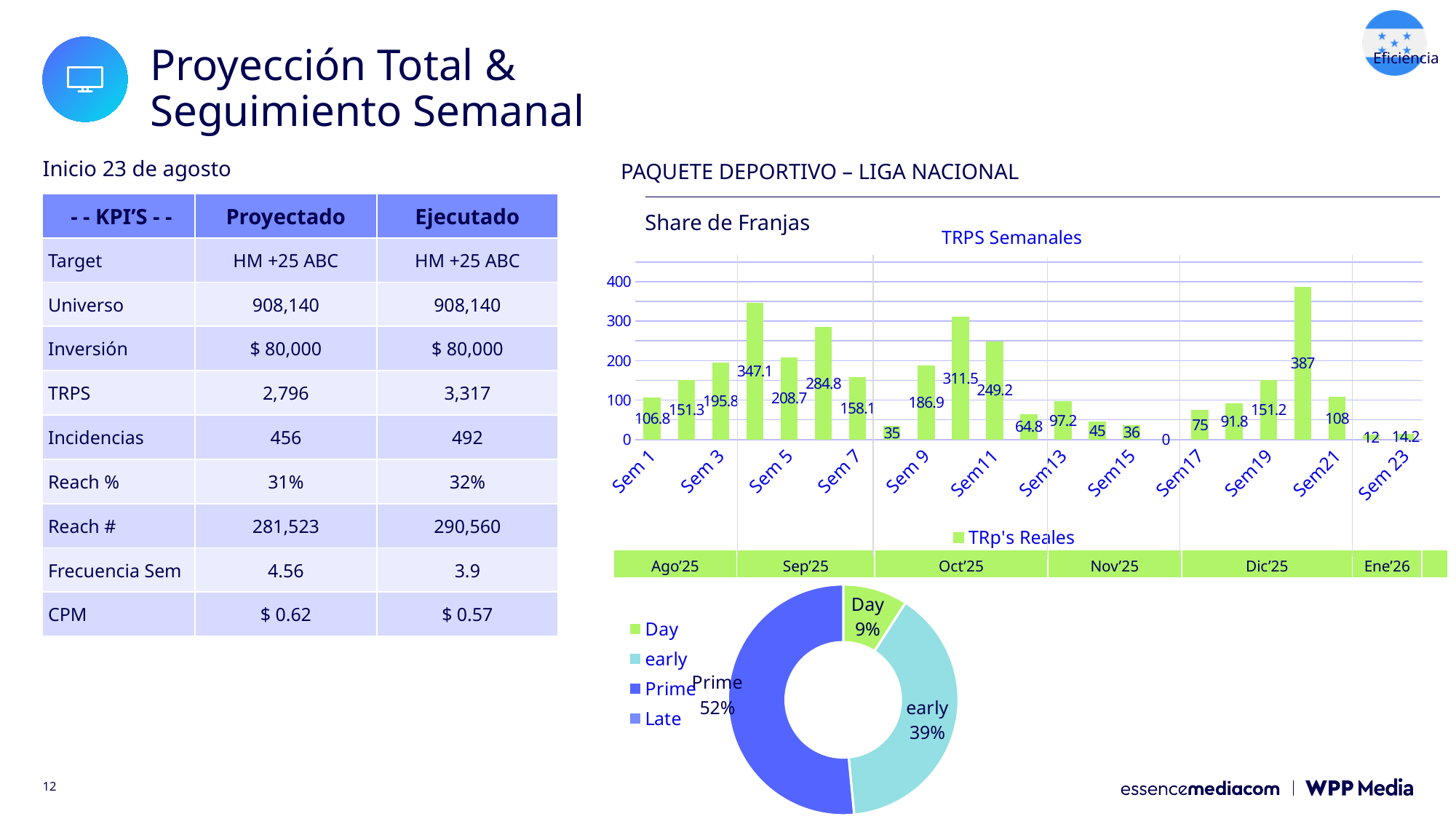
What series name does the legend of the TRPS Semanales chart show? TRp's Reales In the TRPS Semanales bar chart, which is larger, the value for Sem 9 or the value for Sem 13? Sem 9 In the TRPS Semanales bar chart, what is the highest value shown on any bar? 387 What kind of chart is TRPS Semanales? bar chart In the TRPS Semanales bar chart, what is the value for Sem 1? 106.8 In the Share de Franjas donut chart, what share does Prime have? 52% In the TRPS Semanales bar chart, what is the value for Sem 11? 249.2 How many entries does the legend of the Share de Franjas chart list? 4 In the TRPS Semanales bar chart, what is the value for Sem 23? 14.2 In the TRPS Semanales bar chart, is the value for Sem 3 greater or less than 100? greater In the Share de Franjas donut chart, which segment has the smallest labelled share? Day In the TRPS Semanales bar chart, what is the difference between the values for Sem 5 and Sem 7? 50.6